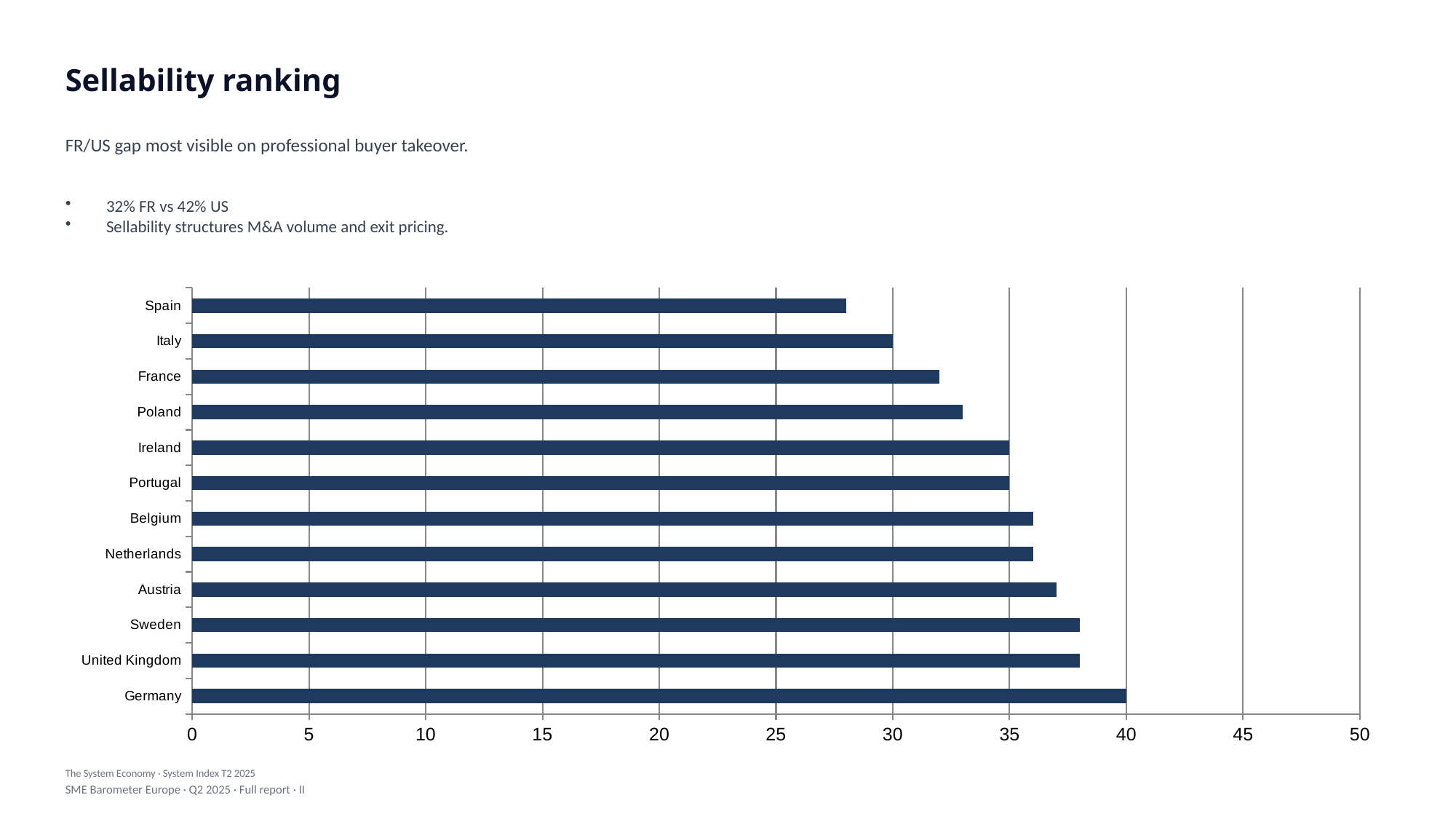
Which country has the lowest value in the chart? Spain What is the title of the slide containing the chart? Sellability ranking What is the value for Ireland? 35 What is the value for Italy? 30 What is the value for Germany? 40 Which is larger, the value for Austria or the value for Poland? Austria How many countries are shown in the chart? 12 What kind of chart is shown on the slide? bar chart Which country has the highest value in the chart? Germany What is the difference between the values for Germany and Italy? 10 Is the value for Austria greater or less than 35? greater Is the value for Spain greater or less than 30? less